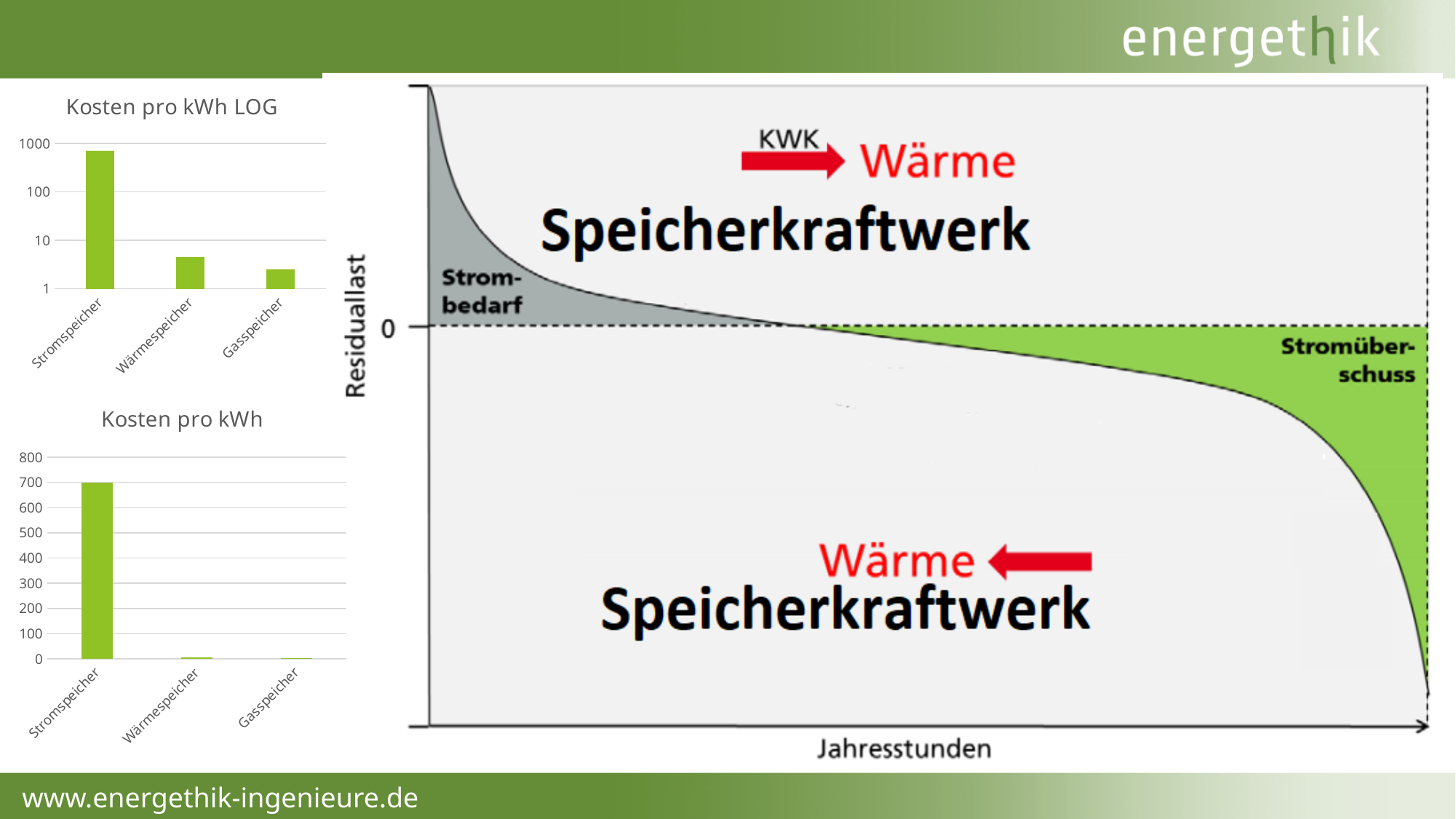
In the 'Kosten pro kWh' chart, is the value for Stromspeicher greater or less than 600? greater In the 'Kosten pro kWh' chart, which category has the highest value? Stromspeicher In the 'Kosten pro kWh LOG' chart, do the values rise or fall from Stromspeicher to Gasspeicher? fall What is the x-axis label of the large diagram on the right side of the slide? Jahresstunden In the 'Kosten pro kWh' chart, is the value for Wärmespeicher greater or less than 100? less In the 'Kosten pro kWh LOG' chart, which is larger, Wärmespeicher or Gasspeicher? Wärmespeicher How many categories are shown in the 'Kosten pro kWh' chart? 3 What kind of chart is the 'Kosten pro kWh LOG' chart? bar chart What is the y-axis label of the large diagram on the right side of the slide? Residuallast In the 'Kosten pro kWh LOG' chart, is the value for Stromspeicher greater or less than 100? greater In the 'Kosten pro kWh LOG' chart, which category has the lowest value? Gasspeicher